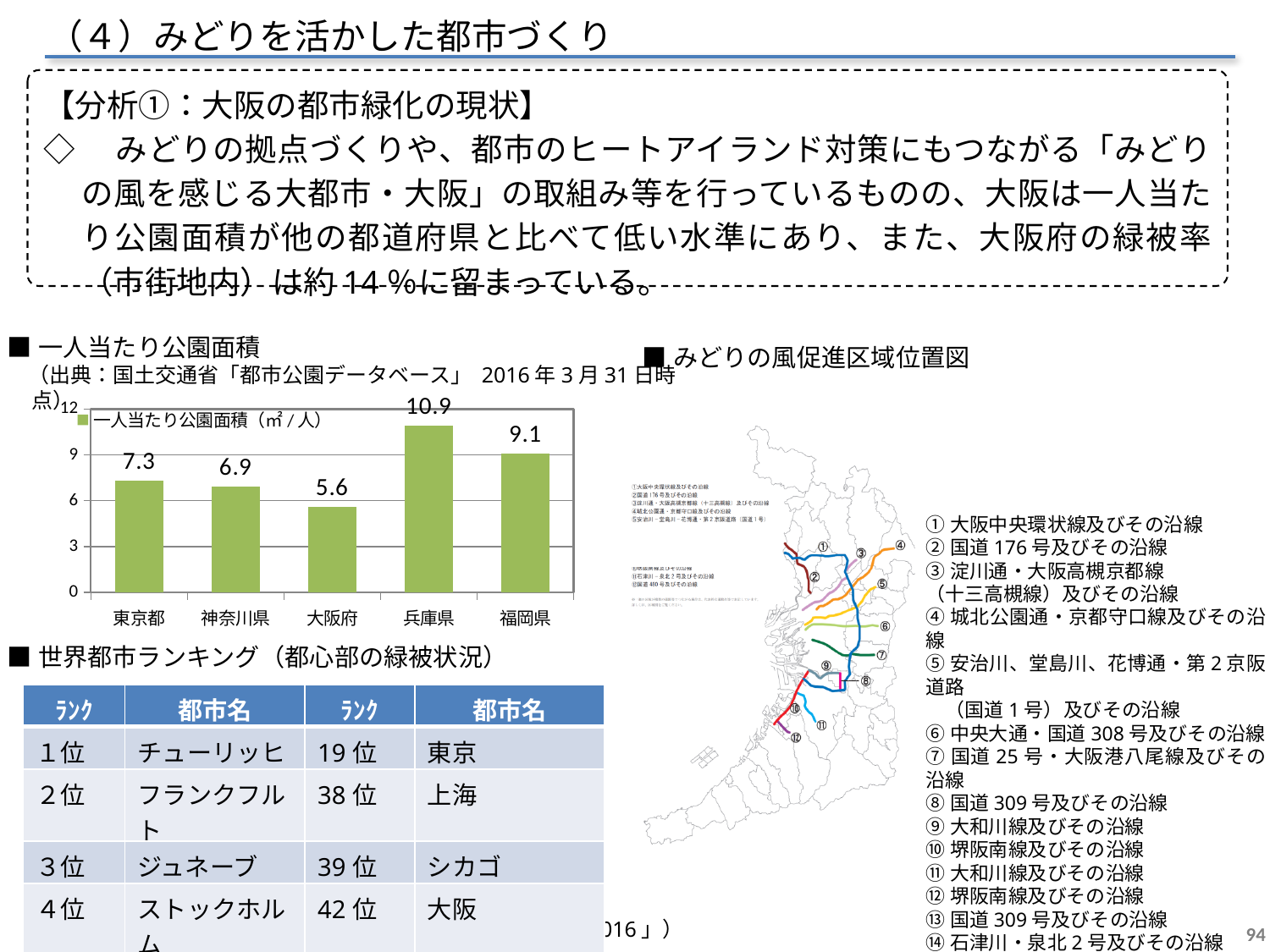
In the 一人当たり公園面積 chart, what is the value for 東京都? 7.3 In the 一人当たり公園面積 chart, which prefecture has the lowest value? 大阪府 What kind of chart is the 一人当たり公園面積 chart? bar chart In the 一人当たり公園面積 chart, what is the difference between the values for 兵庫県 and 大阪府? 5.3 In the 一人当たり公園面積 chart, which is larger, the value for 東京都 or the value for 福岡県? 福岡県 In the 一人当たり公園面積 chart, which prefecture has the highest value? 兵庫県 In the 一人当たり公園面積 chart, is the value for 神奈川県 greater or less than 9? less In the 一人当たり公園面積 chart, what is the value for 兵庫県? 10.9 In the 一人当たり公園面積 chart, what is the value for 大阪府? 5.6 In the 一人当たり公園面積 chart, what is the difference between the values for 福岡県 and 神奈川県? 2.2 What is the legend entry of the 一人当たり公園面積 chart? 一人当たり公園面積（㎡/人） How many prefectures are shown in the 一人当たり公園面積 chart? 5